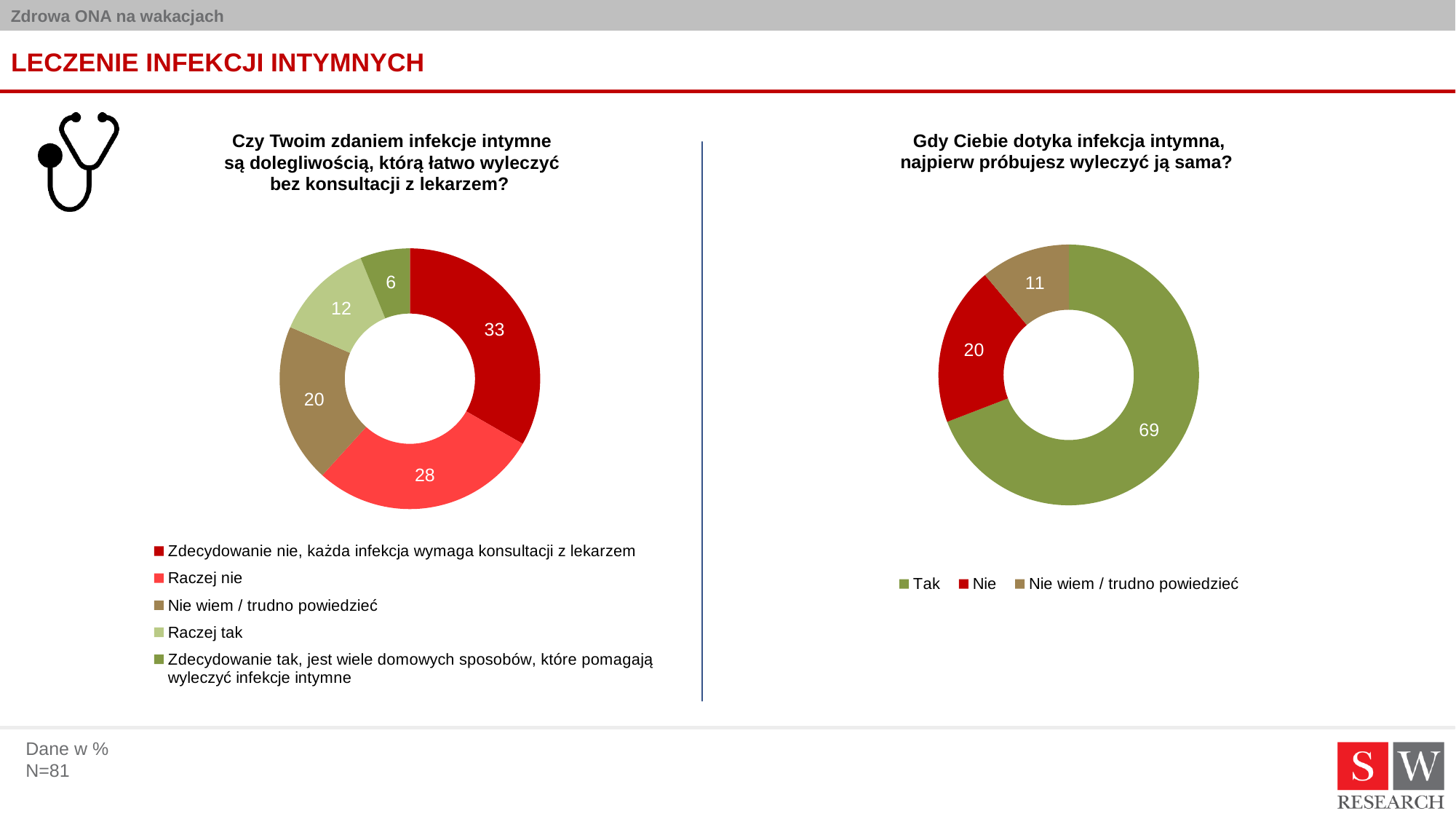
In the right chart ("Gdy Ciebie dotyka infekcja intymna..."), which is larger, "Nie" or "Nie wiem / trudno powiedzieć"? Nie In the right chart ("Gdy Ciebie dotyka infekcja intymna..."), what colour is the "Tak" slice? Green In the left chart ("Czy Twoim zdaniem infekcje intymne..."), what is the value for "Zdecydowanie tak, jest wiele domowych sposobów, które pomagają wyleczyć infekcje intymne"? 6 In the left chart ("Czy Twoim zdaniem infekcje intymne..."), what is the difference between "Zdecydowanie nie" and "Raczej tak"? 21 In the right chart ("Gdy Ciebie dotyka infekcja intymna..."), what is the difference between "Tak" and "Nie"? 49 In the right chart ("Gdy Ciebie dotyka infekcja intymna..."), what is the value for "Nie wiem / trudno powiedzieć"? 11 In the left chart ("Czy Twoim zdaniem infekcje intymne..."), which category has the highest value? Zdecydowanie nie, każda infekcja wymaga konsultacji z lekarzem In the left chart ("Czy Twoim zdaniem infekcje intymne są dolegliwością, którą łatwo wyleczyć bez konsultacji z lekarzem?"), what is the value for "Raczej nie"? 28 In the right chart ("Gdy Ciebie dotyka infekcja intymna, najpierw próbujesz wyleczyć ją sama?"), what is the value for "Tak"? 69 In the left chart ("Czy Twoim zdaniem infekcje intymne..."), which category has the lowest value? Zdecydowanie tak, jest wiele domowych sposobów, które pomagają wyleczyć infekcje intymne In the left chart ("Czy Twoim zdaniem infekcje intymne..."), how many categories does the legend list? 5 What kind of chart is the right chart ("Gdy Ciebie dotyka infekcja intymna...")? Donut (pie) chart